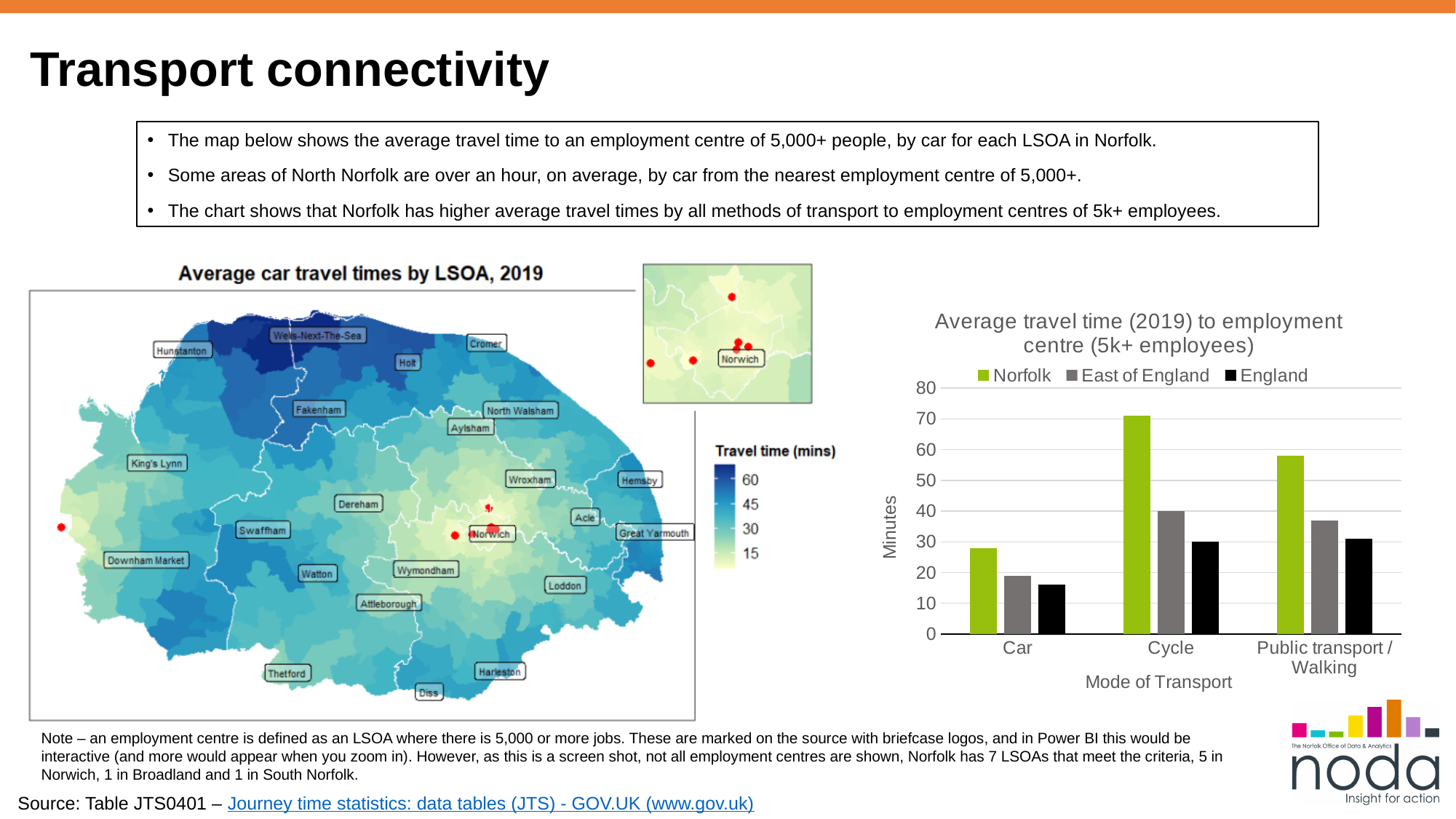
What kind of chart is the 'Average travel time (2019) to employment centre (5k+ employees)' chart? bar chart In the bar chart, which mode of transport has the highest average travel time for Norfolk? Cycle In the bar chart, is the Norfolk value for Car greater or less than 30? less In the bar chart, is the Norfolk value for Public transport / Walking greater or less than 50? greater Which series in the bar chart is shown in green? Norfolk How many series does the legend of the bar chart list? 3 How many modes of transport are shown on the x axis of the bar chart? 3 What is the label on the y axis of the bar chart? Minutes In the bar chart, which mode of transport has the lowest average travel time for England? Car In the bar chart, which is larger for Cycle: the Norfolk value or the East of England value? Norfolk In the bar chart, is the England value for Car greater or less than 20? less